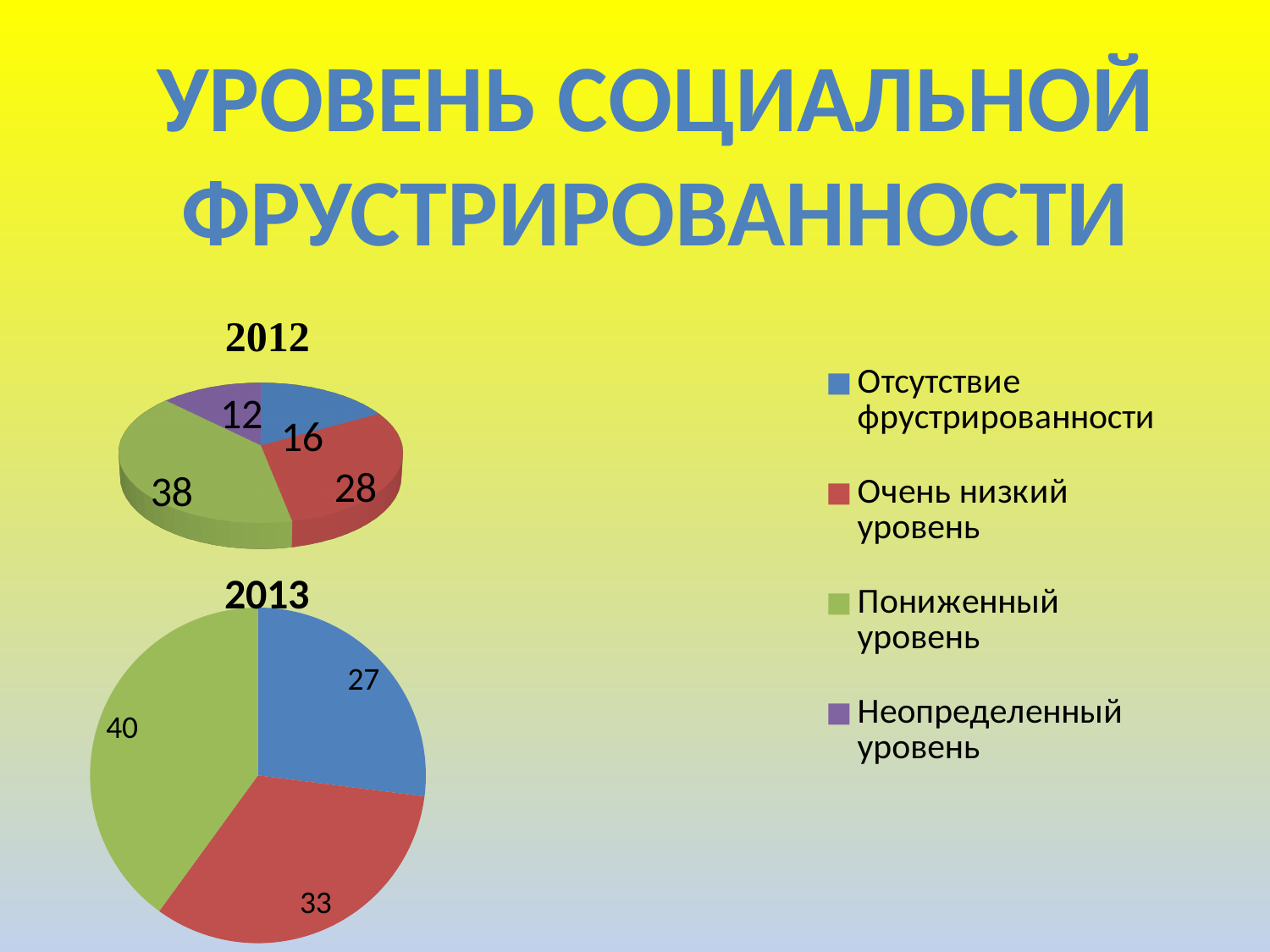
How many slices does the 2013 chart have? 3 How many entries does the legend list? 4 In the 2012 chart, what is the value for Пониженный уровень? 38 What kind of chart is the 2012 chart? Pie chart In the 2012 chart, what is the difference between the values for Очень низкий уровень and Отсутствие фрустрированности? 12 In the 2013 chart, what is the value for Отсутствие фрустрированности? 27 In the 2012 chart, which category has the largest slice? Пониженный уровень In the 2013 chart, which is larger: Пониженный уровень or Очень низкий уровень? Пониженный уровень In the 2013 chart, which category has the smallest slice? Отсутствие фрустрированности In the 2012 chart, what is the value for Неопределенный уровень? 12 In the 2012 chart, which category has the smallest slice? Неопределенный уровень In the 2013 chart, what is the value for Очень низкий уровень? 33